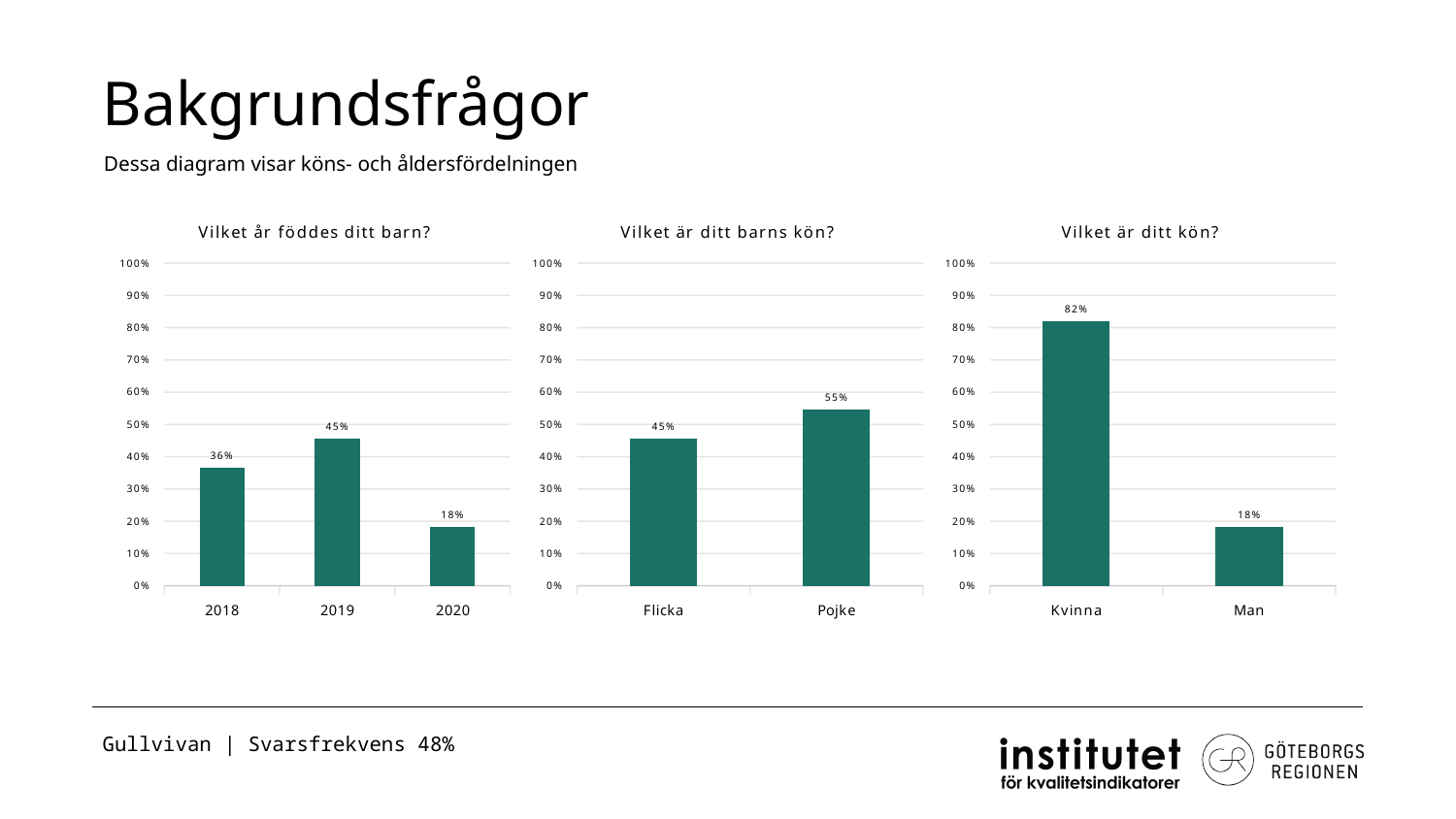
In the chart titled "Vilket år föddes ditt barn?", which year has the lowest value? 2020 How many charts are shown on the slide? 3 What kind of chart is the chart titled "Vilket är ditt kön?"? bar chart In the chart titled "Vilket år föddes ditt barn?", what is the value for 2019? 45% In the chart titled "Vilket år föddes ditt barn?", what is the difference between the values for 2019 and 2018? 9% In the chart titled "Vilket är ditt kön?", what is the value for Man? 18% In the chart titled "Vilket är ditt barns kön?", what is the value for Pojke? 55% In the chart titled "Vilket är ditt barns kön?", what is the difference between the values for Pojke and Flicka? 10% In the chart titled "Vilket år föddes ditt barn?", how many categories are shown on the x axis? 3 In the chart titled "Vilket är ditt kön?", is the value for Kvinna greater or less than 80%? greater In the chart titled "Vilket är ditt barns kön?", which category is higher, Flicka or Pojke? Pojke In the chart titled "Vilket är ditt kön?", what is the value for Kvinna? 82%